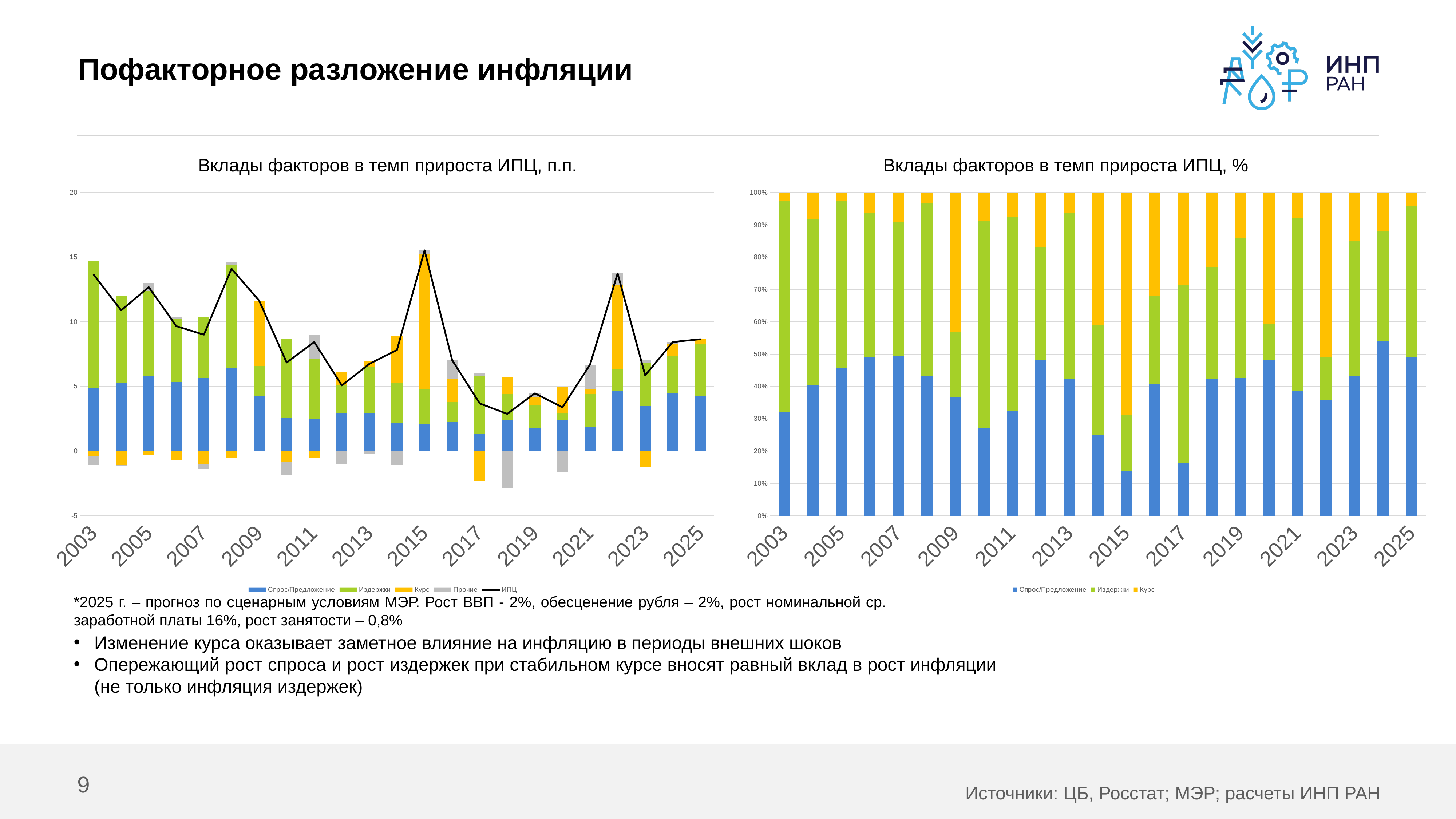
On the left chart, is the ИПЦ value for 2015 greater or less than 10? greater On the right chart, is the share of Спрос/Предложение in 2015 greater or less than 20%? less What kind of chart is the right chart titled "Вклады факторов в темп прироста ИПЦ, %"? 100% stacked bar chart On the right chart, in which year is the share of Курс the largest? 2015 Which series on the left chart is drawn as a line rather than bars? ИПЦ What kind of chart is the left chart titled "Вклады факторов в темп прироста ИПЦ, п.п."? Stacked bar chart with a line How many series does the legend of the left chart list? 5 On the left chart, in which year does the ИПЦ line reach its highest value? 2015 On the left chart, is the ИПЦ value for 2017 greater or less than 5? less How many series does the legend of the right chart list? 3 How many years (bars) are shown on the right chart? 23